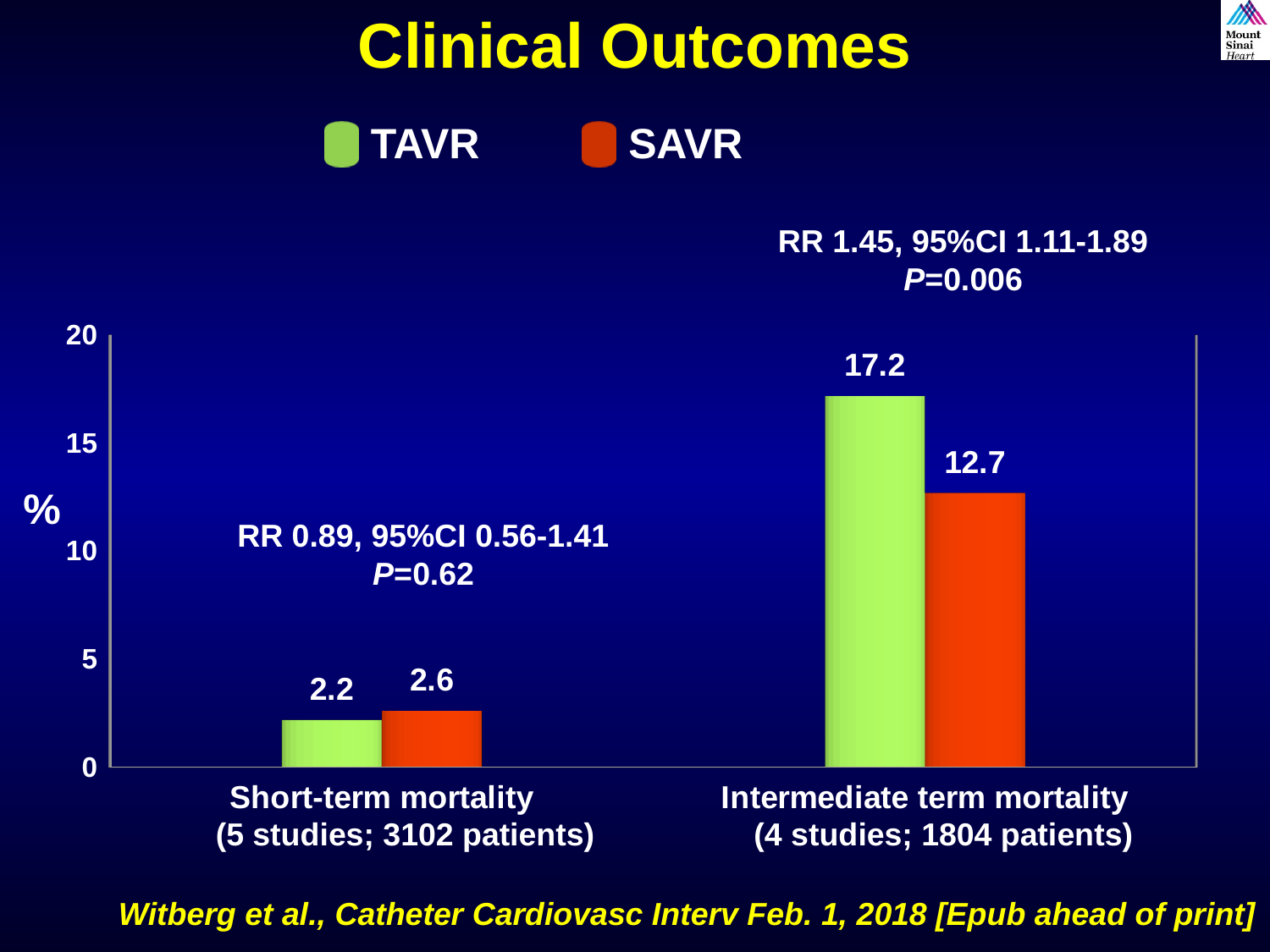
Which series has the highest value for Intermediate term mortality? TAVR Is the TAVR value for Intermediate term mortality greater or less than 15? greater Which series has the lowest value for Short-term mortality? TAVR How many categories are shown on the x axis? 2 How many series does the legend list? 2 What is the SAVR value for Intermediate term mortality? 12.7 Which is larger for Short-term mortality, TAVR or SAVR? SAVR What is the TAVR value for Intermediate term mortality? 17.2 What is the SAVR value for Short-term mortality? 2.6 What is the TAVR value for Short-term mortality? 2.2 What is the difference between the TAVR and SAVR values for Intermediate term mortality? 4.5 What kind of chart is shown on the slide? bar chart